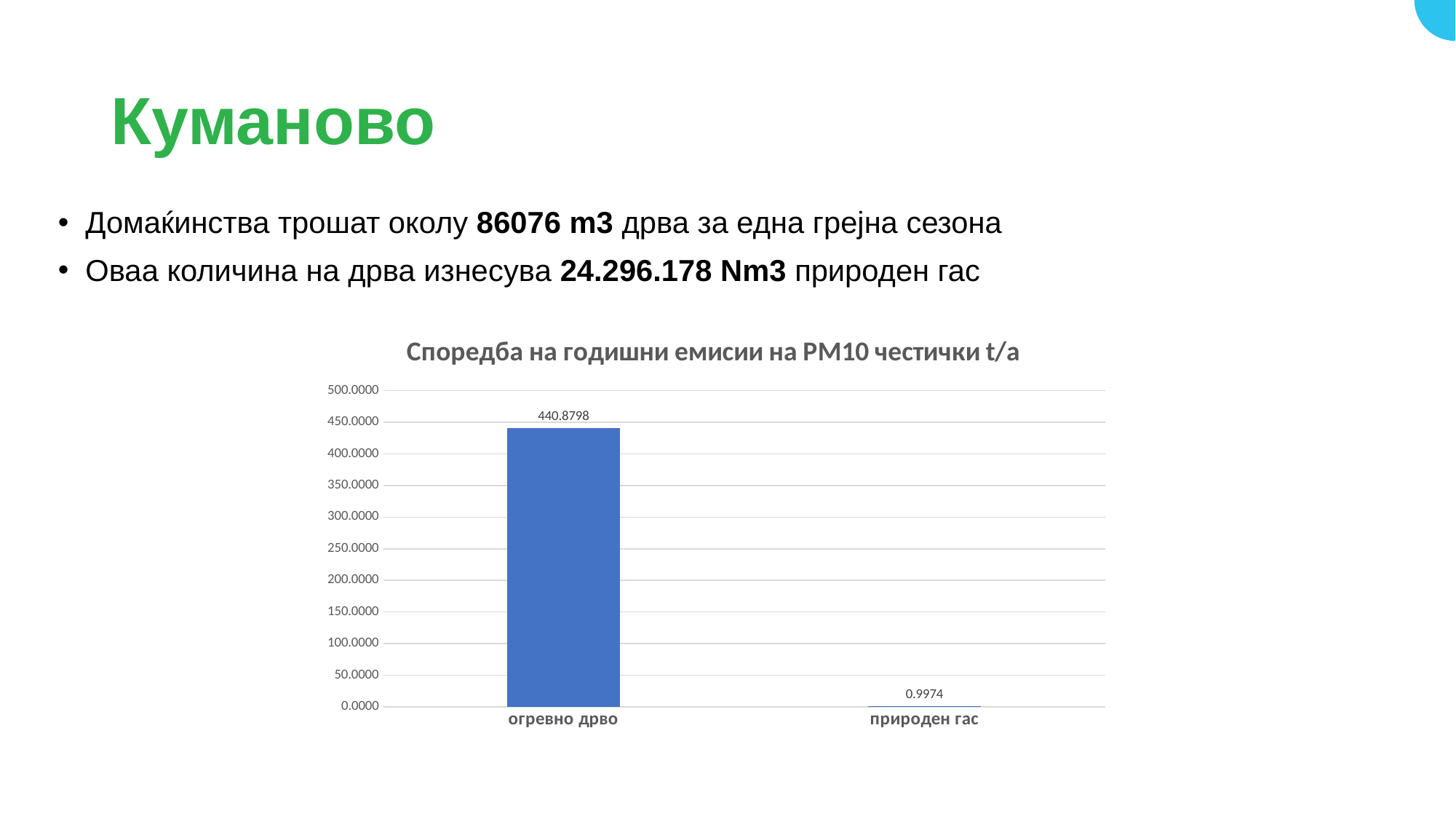
What is the highest value shown on the y axis? 500.0000 What is the difference between the values for огревно дрво and природен гас? 439.8824 Which category has the highest value? огревно дрво Which category has the lowest value? природен гас What is the value for огревно дрво? 440.8798 What kind of chart is shown on the slide? bar chart How many categories are shown on the x axis? 2 What is the title of the chart? Споредба на годишни емисии на PM10 честички t/a Is the value for природен гас greater or less than 50.0000? less Is the value for огревно дрво greater or less than 400.0000? greater Which is larger, the value for огревно дрво or the value for природен гас? огревно дрво What is the value for природен гас? 0.9974